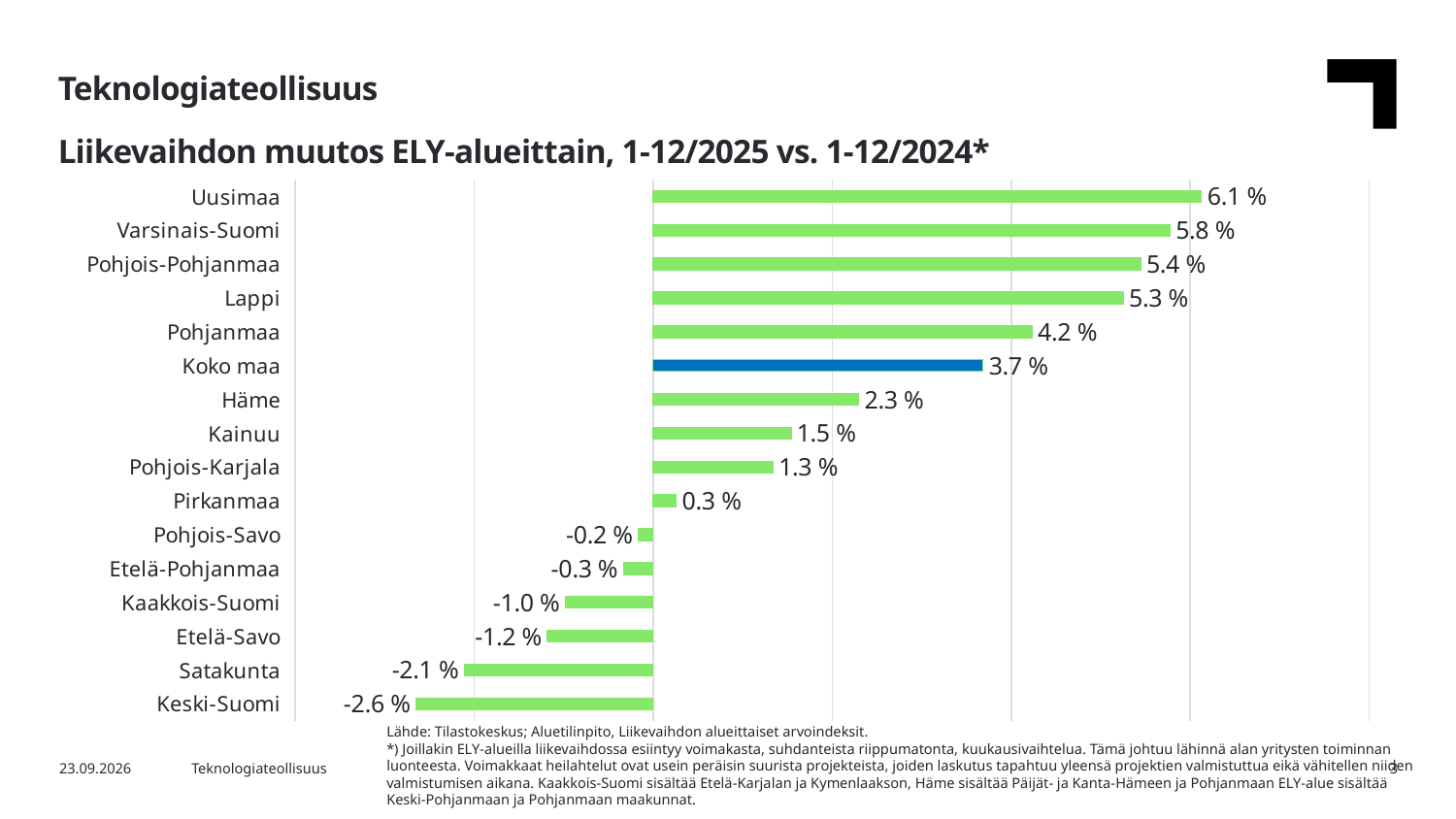
Which ELY area has the lowest value? Keski-Suomi What is the value for Koko maa? 3.7 % What is the value for Pirkanmaa? 0.3 % What is the value for Keski-Suomi? -2.6 % Which bar is shown in a different colour (dark blue) from the others? Koko maa What is the difference between the values for Lappi and Pohjanmaa? 1.1 percentage points How many ELY areas (categories) are shown in the chart? 16 What is the value for Uusimaa? 6.1 % Which ELY area has the highest value? Uusimaa What is the difference between the values for Uusimaa and Keski-Suomi? 8.7 percentage points What kind of chart is shown on the slide? Bar chart Which has the larger value, Häme or Kainuu? Häme